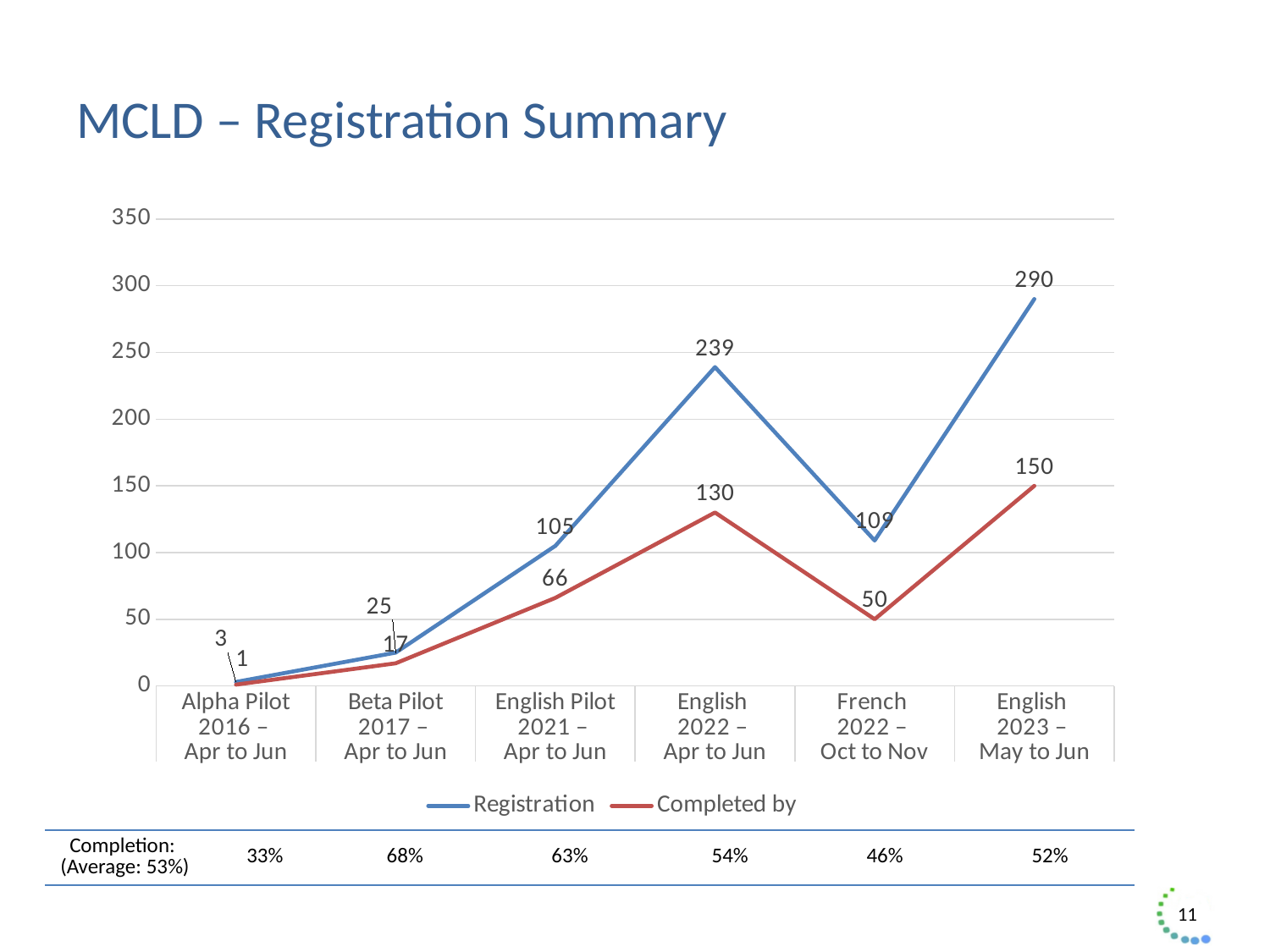
What kind of chart is shown on the slide? line chart Does the Registration series rise or fall from French 2022 – Oct to Nov to English 2023 – May to Jun? rise What is the Registration value for French 2022 – Oct to Nov? 109 Which category has the highest Registration value? English 2023 – May to Jun Which is larger: the Registration value for English Pilot 2021 – Apr to Jun or the Registration value for French 2022 – Oct to Nov? French 2022 – Oct to Nov How many categories are shown on the x axis? 6 What is the title of the slide? MCLD – Registration Summary What is the difference between Registration and Completed by for English 2022 – Apr to Jun? 109 What is the Registration value for English 2023 – May to Jun? 290 What is the Completed by value for English 2022 – Apr to Jun? 130 How many series does the legend list? 2 Which category has the lowest Completed by value? Alpha Pilot 2016 – Apr to Jun